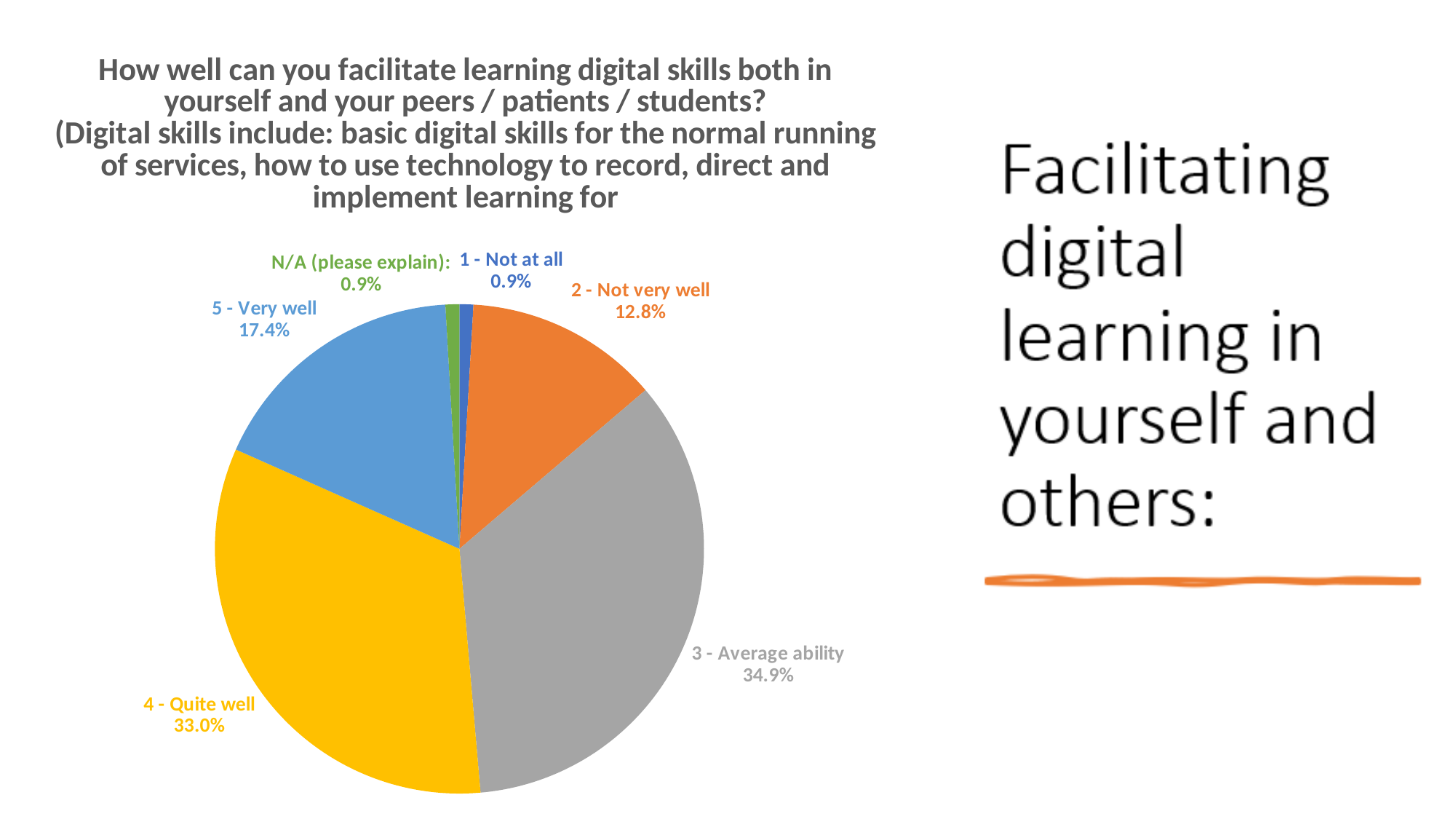
What is the difference in percentage points between "3 - Average ability" and "4 - Quite well"? 1.9 What is the difference in percentage points between "5 - Very well" and "2 - Not very well"? 4.6 What percentage is shown for "1 - Not at all"? 0.9% What share of the pie is labelled "3 - Average ability"? 34.9% How many categories are shown in the pie chart? 6 What share of the pie is labelled "4 - Quite well"? 33.0% What percentage is shown for "2 - Not very well"? 12.8% Which category has the largest slice of the pie? 3 - Average ability What kind of chart is shown on the slide? Pie chart Which is larger, the slice for "5 - Very well" or the slice for "2 - Not very well"? 5 - Very well What percentage is shown for "5 - Very well"? 17.4% What colour is the slice for "4 - Quite well"? Yellow